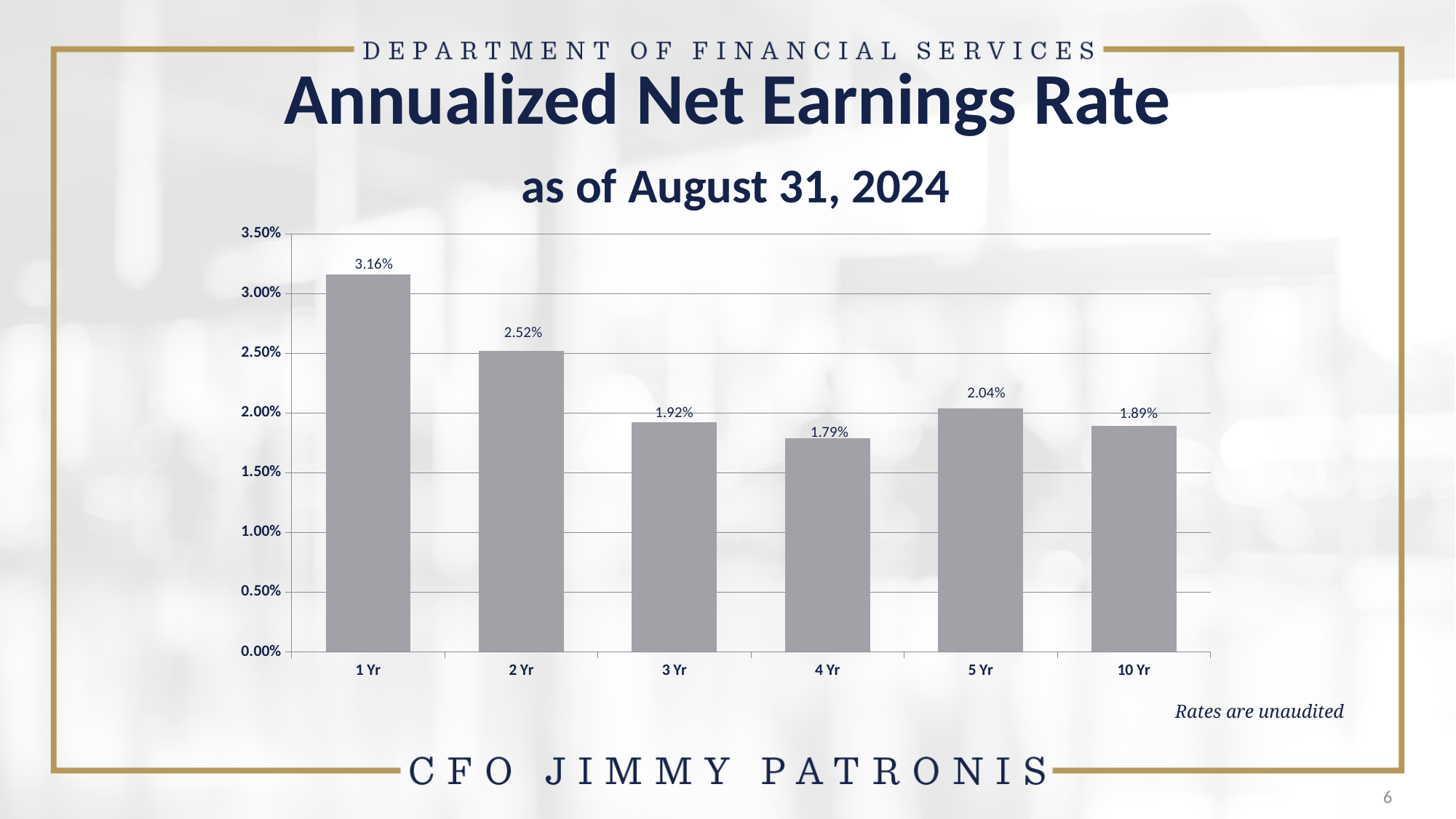
What is the annualized net earnings rate for 1 Yr? 3.16% What is the annualized net earnings rate for 10 Yr? 1.89% What is the difference between the 1 Yr and 2 Yr rates? 0.64% What is the value shown for 5 Yr? 2.04% Which period has the highest annualized net earnings rate? 1 Yr What is the difference between the 5 Yr and 4 Yr rates? 0.25% Which period has the lowest annualized net earnings rate? 4 Yr As of what date are the annualized net earnings rates reported? August 31, 2024 Is the value for 2 Yr greater or less than 2.50%? greater What kind of chart is shown on the slide? Bar chart How many periods are shown on the chart? 6 Which is larger, the 3 Yr rate or the 10 Yr rate? 3 Yr